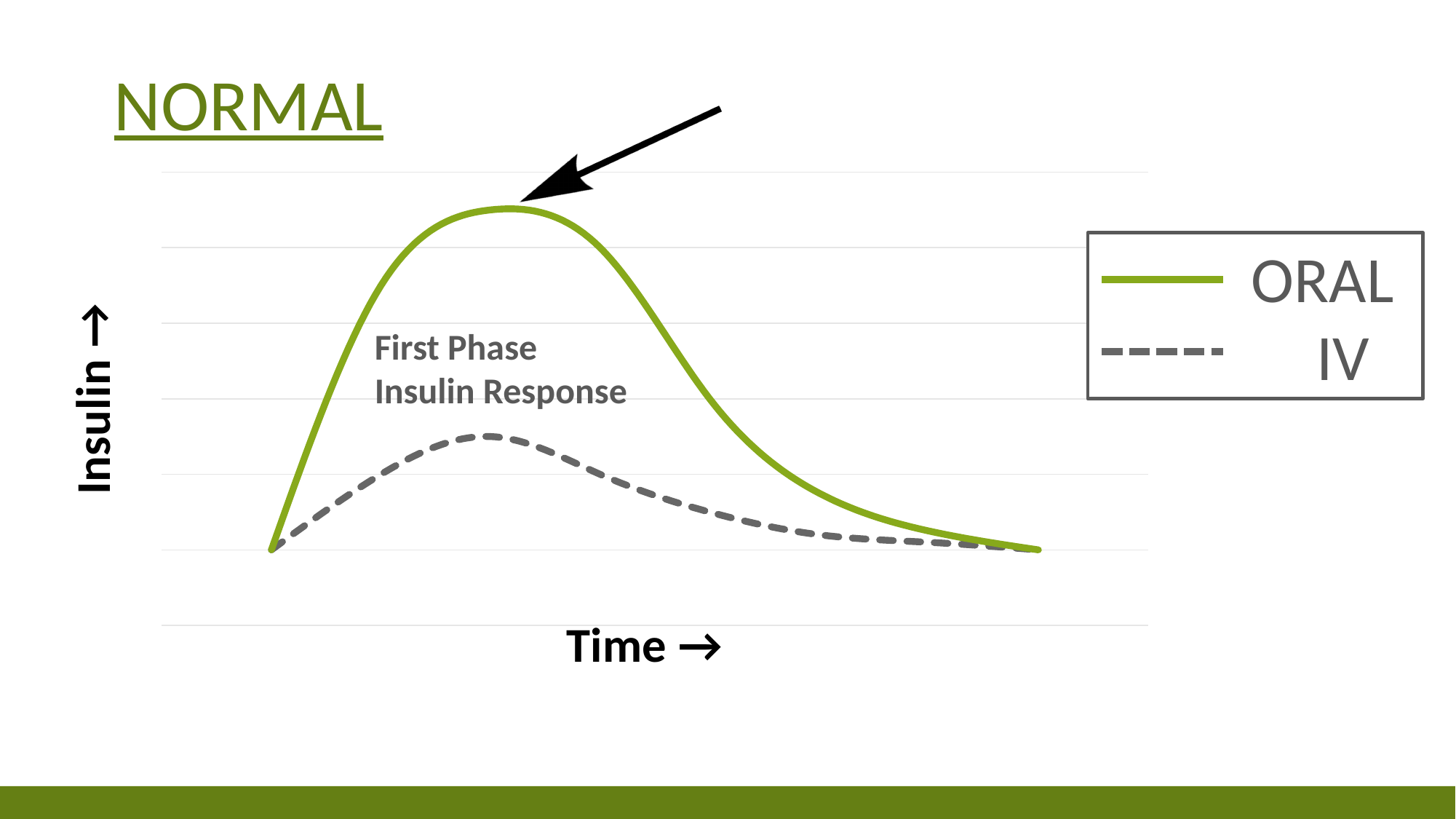
How does the ORAL insulin curve change along the time axis? Rises to a peak, then falls Which series reaches the higher peak insulin level, ORAL or IV? ORAL How many series does the legend list? 2 What kind of chart is shown on the slide? Line chart Which series shows the highest insulin value on the chart? ORAL Which series has the lower peak, ORAL or IV? IV Which series is drawn with a dashed line? IV What label is on the horizontal axis of the chart? Time How does the IV insulin curve change along the time axis? Rises to a peak, then falls What is the title of the chart? NORMAL